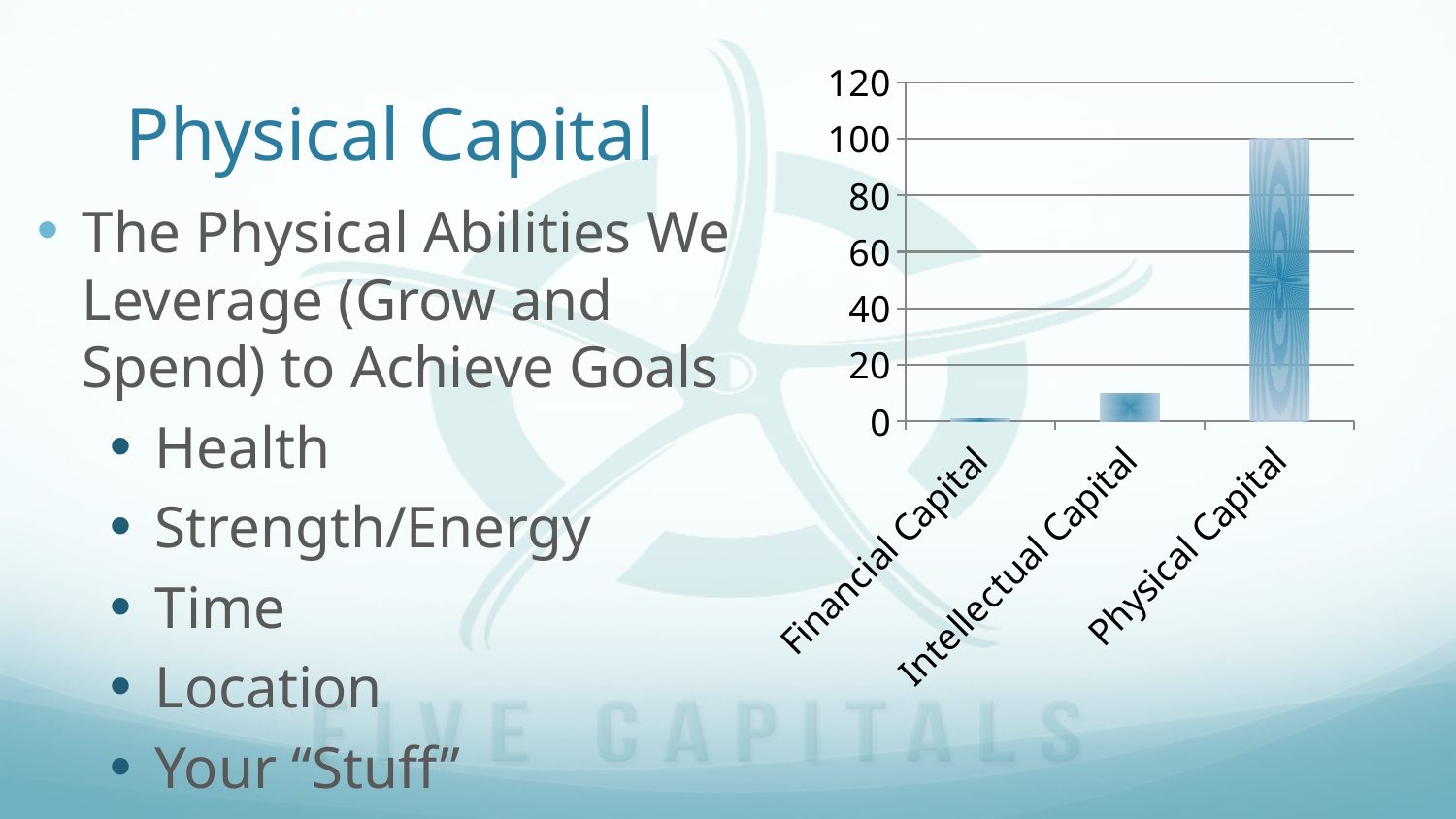
Which is larger, the bar for Physical Capital or the bar for Intellectual Capital? Physical Capital What is the highest value shown on the chart's vertical axis? 120 What is the value of the Physical Capital bar? 100 Which is larger, the bar for Intellectual Capital or the bar for Financial Capital? Intellectual Capital Is the value for Financial Capital greater or less than 20? less What are the category labels on the chart's horizontal axis, from left to right? Financial Capital, Intellectual Capital, Physical Capital Which category has the highest bar on the chart? Physical Capital Is the value for Intellectual Capital greater or less than 20? less Is the value for Physical Capital greater or less than 80? greater Which category has the lowest bar on the chart? Financial Capital How many categories are plotted on the chart? 3 What kind of chart is shown on the slide? bar chart